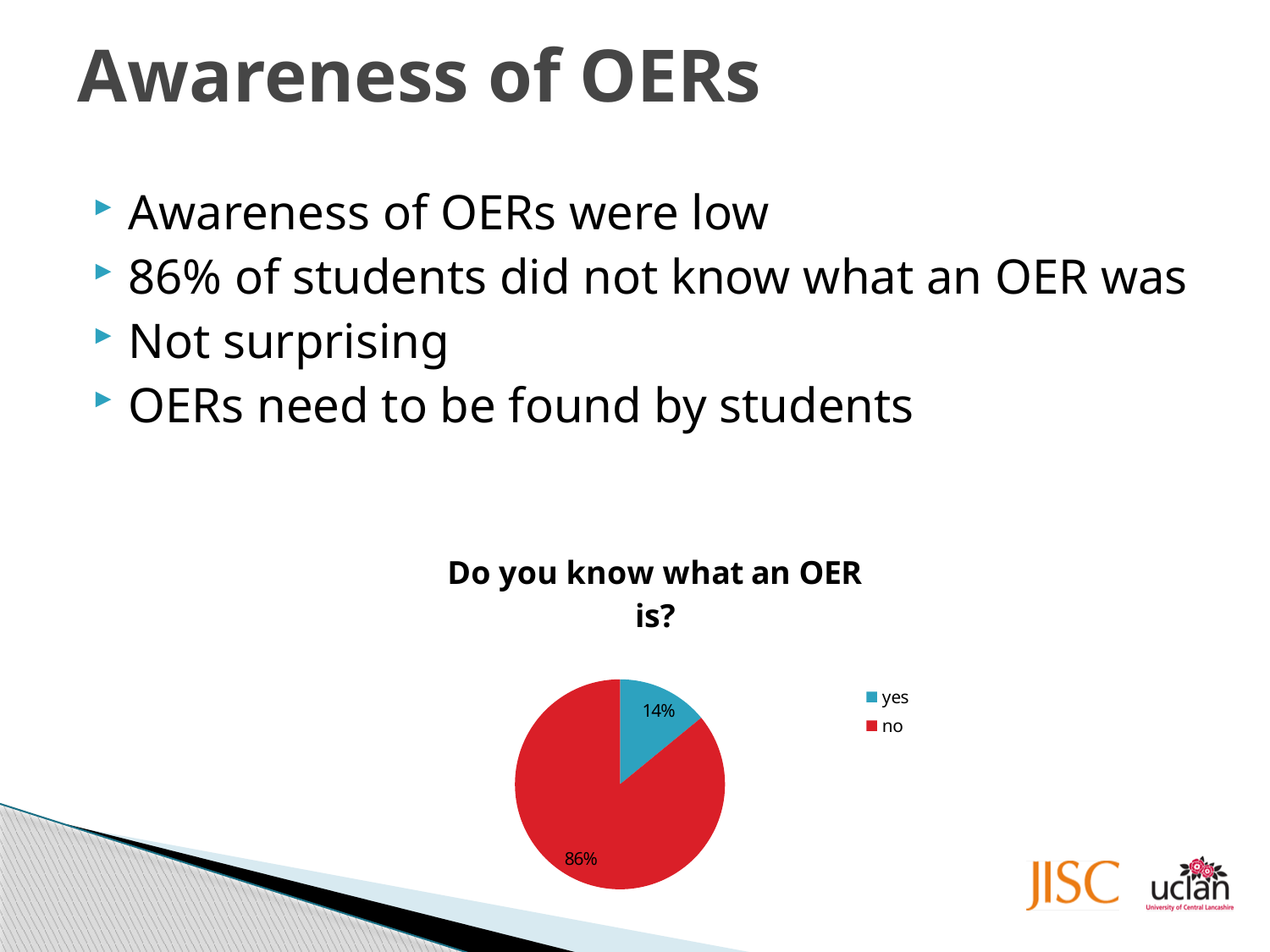
What percentage of the pie is the 'no' slice? 86% What is the title of the chart? Do you know what an OER is? What kind of chart is shown on the slide? pie chart How many slices does the pie chart have? 2 Which slice is the largest in the pie chart? no What colour is the 'no' slice in the pie chart? red Which slice is the smallest in the pie chart? yes How many entries does the legend list? 2 What percentage of the pie is the 'yes' slice? 14% Which is larger, the 'yes' slice or the 'no' slice? no What is the difference in percentage points between the 'no' and 'yes' slices? 72 What share of the pie does the 'yes' slice represent? 14%